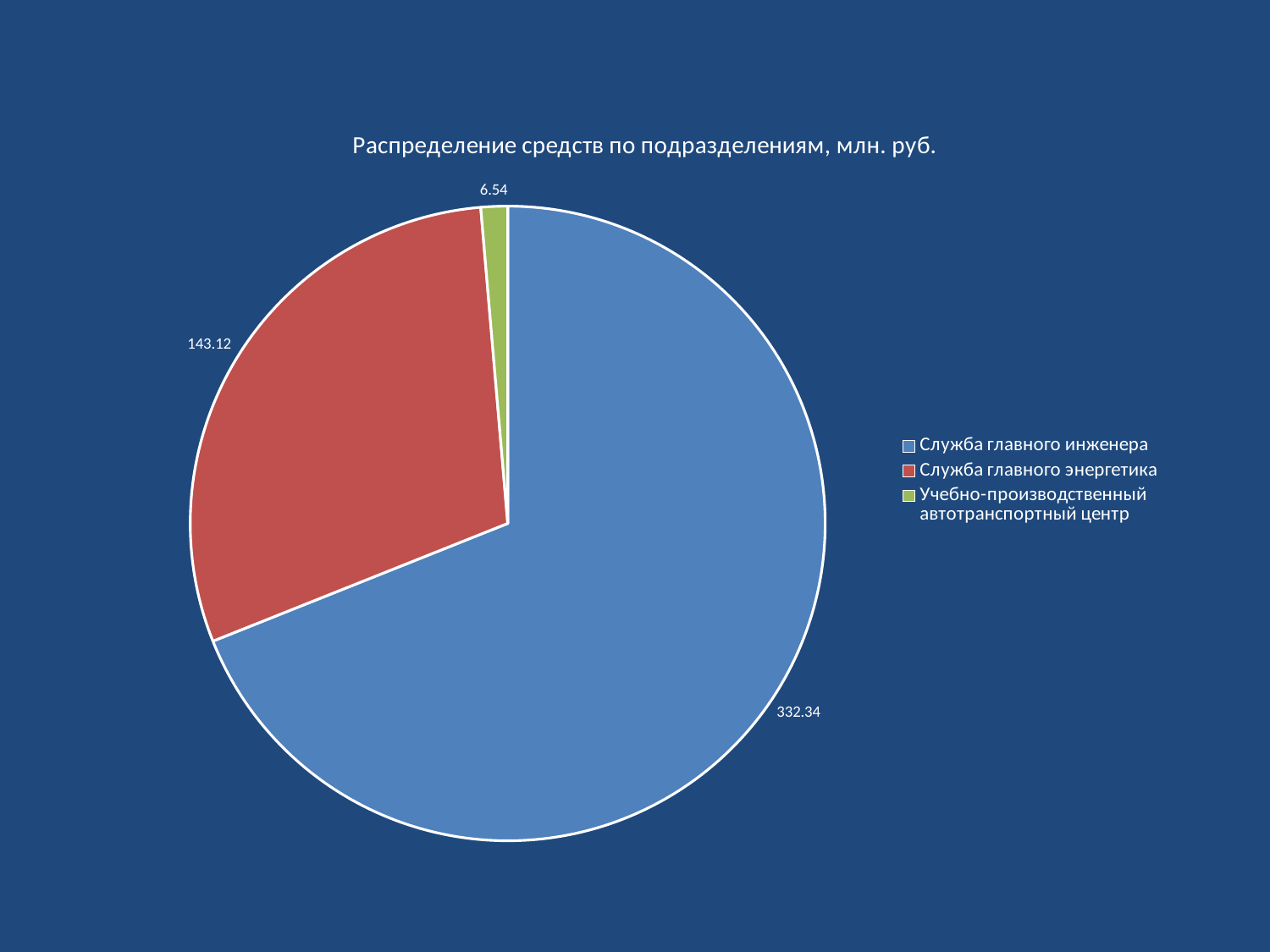
What is the value for Учебно-производственный автотранспортный центр? 6.54 Which is larger: the value for Служба главного энергетика or for Учебно-производственный автотранспортный центр? Служба главного энергетика What is the difference between the values for Служба главного энергетика and Учебно-производственный автотранспортный центр? 136.58 Which division has the largest share of funds? Служба главного инженера What is the title of the chart? Распределение средств по подразделениям, млн. руб. What type of chart is shown on the slide? pie chart What is the value for Служба главного энергетика? 143.12 How many slices does the pie chart have? 3 Which division has the smallest share of funds? Учебно-производственный автотранспортный центр What is the value for Служба главного инженера? 332.34 What is the difference between the values for Служба главного инженера and Служба главного энергетика? 189.22 What is the total of all slices in the pie chart? 482.00